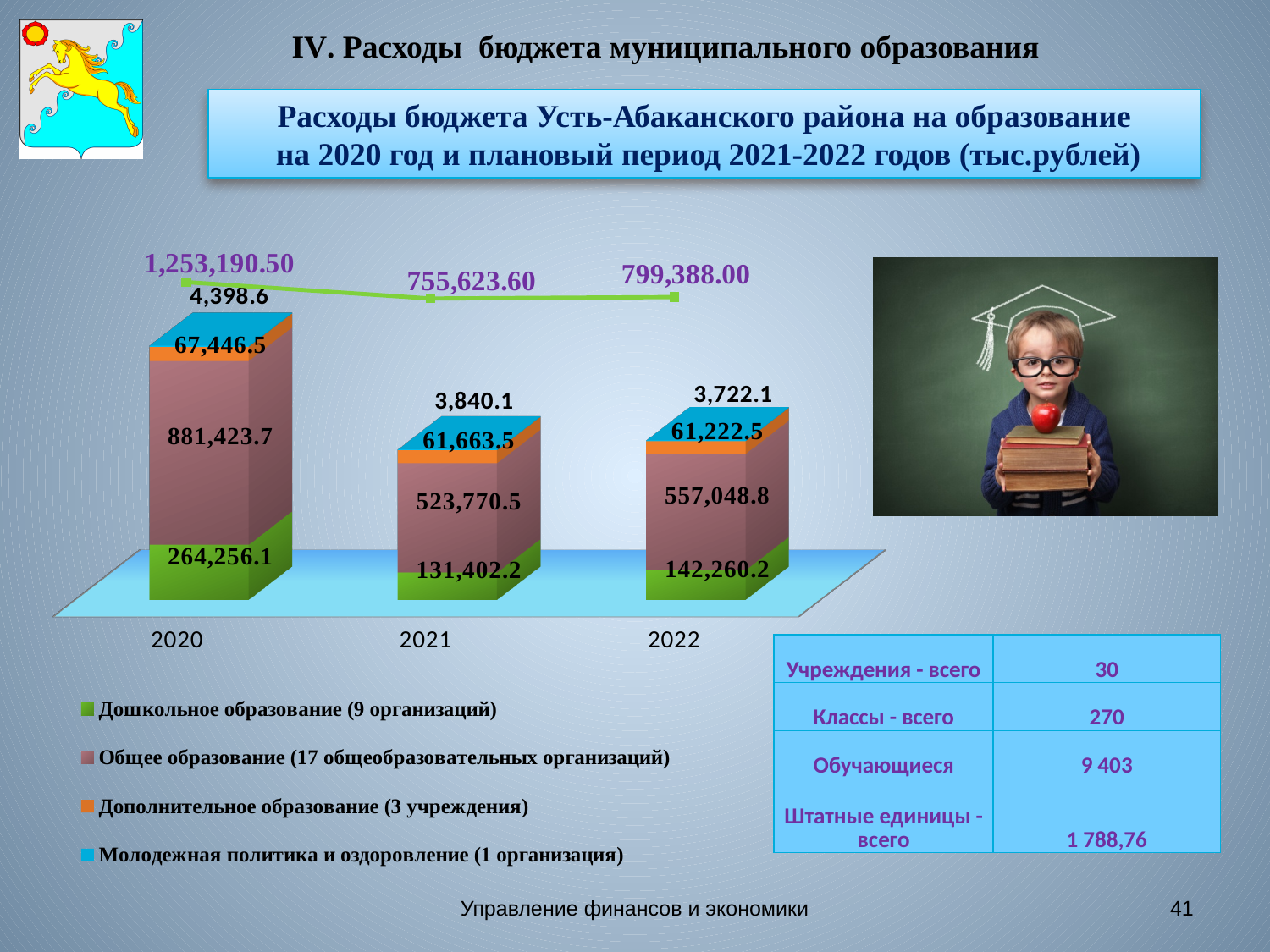
What is the value for Молодежная политика и оздоровление in 2022? 3,722.1 How many years are shown on the x axis of the chart? 3 How many series does the legend list? 4 Which year has the larger value for Дополнительное образование, 2021 or 2022? 2021 What is the value for Дошкольное образование in 2021? 131,402.2 In which year is the value for Общее образование the highest? 2020 What kind of chart is used to show the education expenditures by year? Stacked bar chart What is the difference between the line values for 2022 and 2021? 43,764.40 What is the value for Общее образование in 2020? 881,423.7 In which year is the value for Дошкольное образование the lowest? 2021 What value does the line show for 2021? 755,623.60 By how much does the value for Дошкольное образование in 2022 exceed the value in 2021? 10,858.0